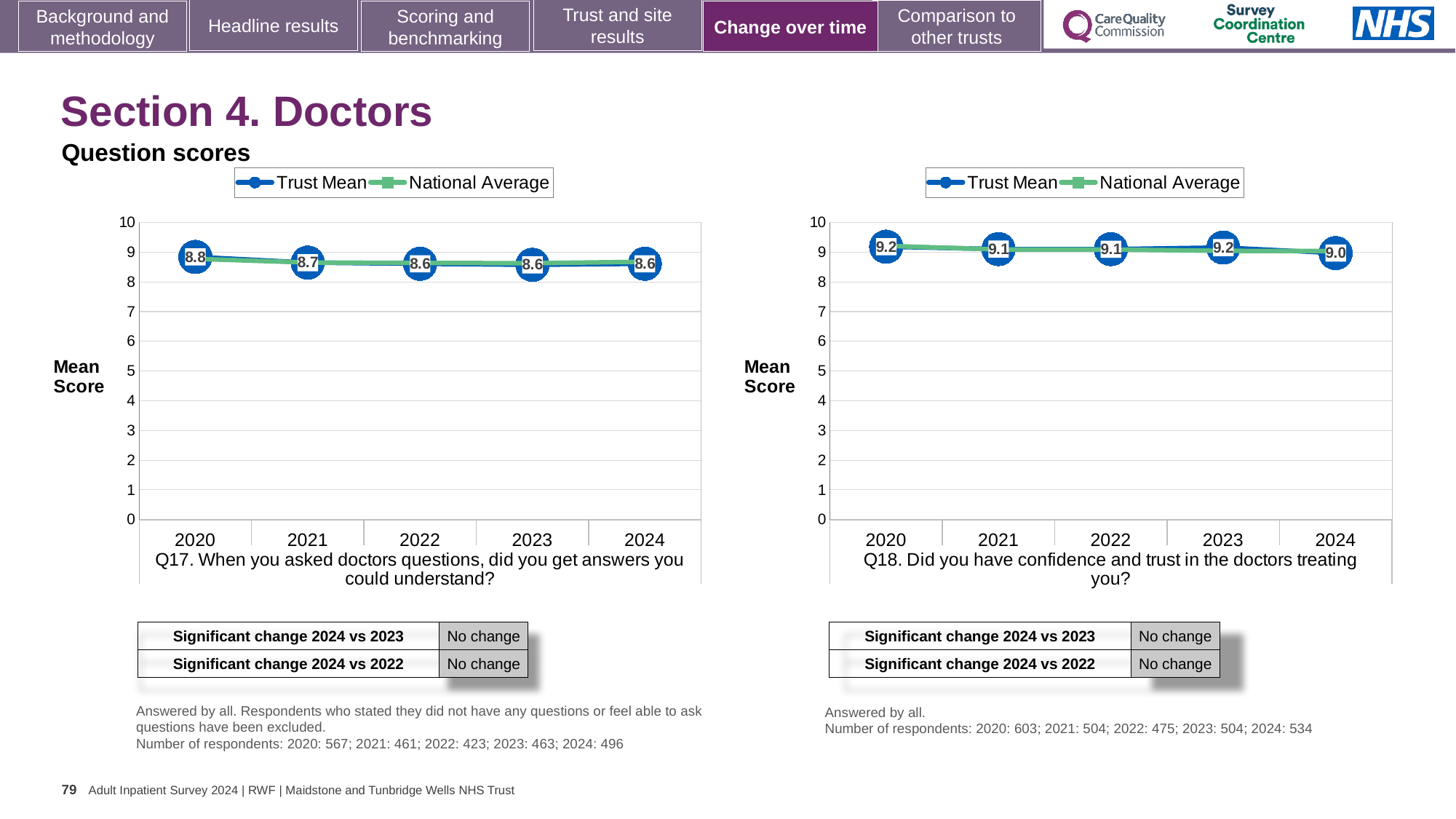
On the Q18 chart (right), what is the Trust Mean score for 2024? 9.0 How many years are shown on the x axis of the Q18 chart (right)? 5 What kind of chart is the Q17 chart (left)? Line chart On the Q17 chart (left), what is the difference between the Trust Mean scores for 2020 and 2024? 0.2 On the Q18 chart (right), what is the Trust Mean score for 2023? 9.2 On the Q17 chart (left), what is the Trust Mean score for 2020? 8.8 On the Q17 chart (left), is the Trust Mean score for 2022 greater or less than 8? greater How many series does the legend of the Q17 chart (left) list? 2 On the Q18 chart (right), which year has the lowest Trust Mean score? 2024 On the Q17 chart (left), which year has the highest Trust Mean score? 2020 On the Q18 chart (right), which is larger, the Trust Mean score for 2020 or for 2024? 2020 On the Q17 chart (left), what is the Trust Mean score for 2024? 8.6